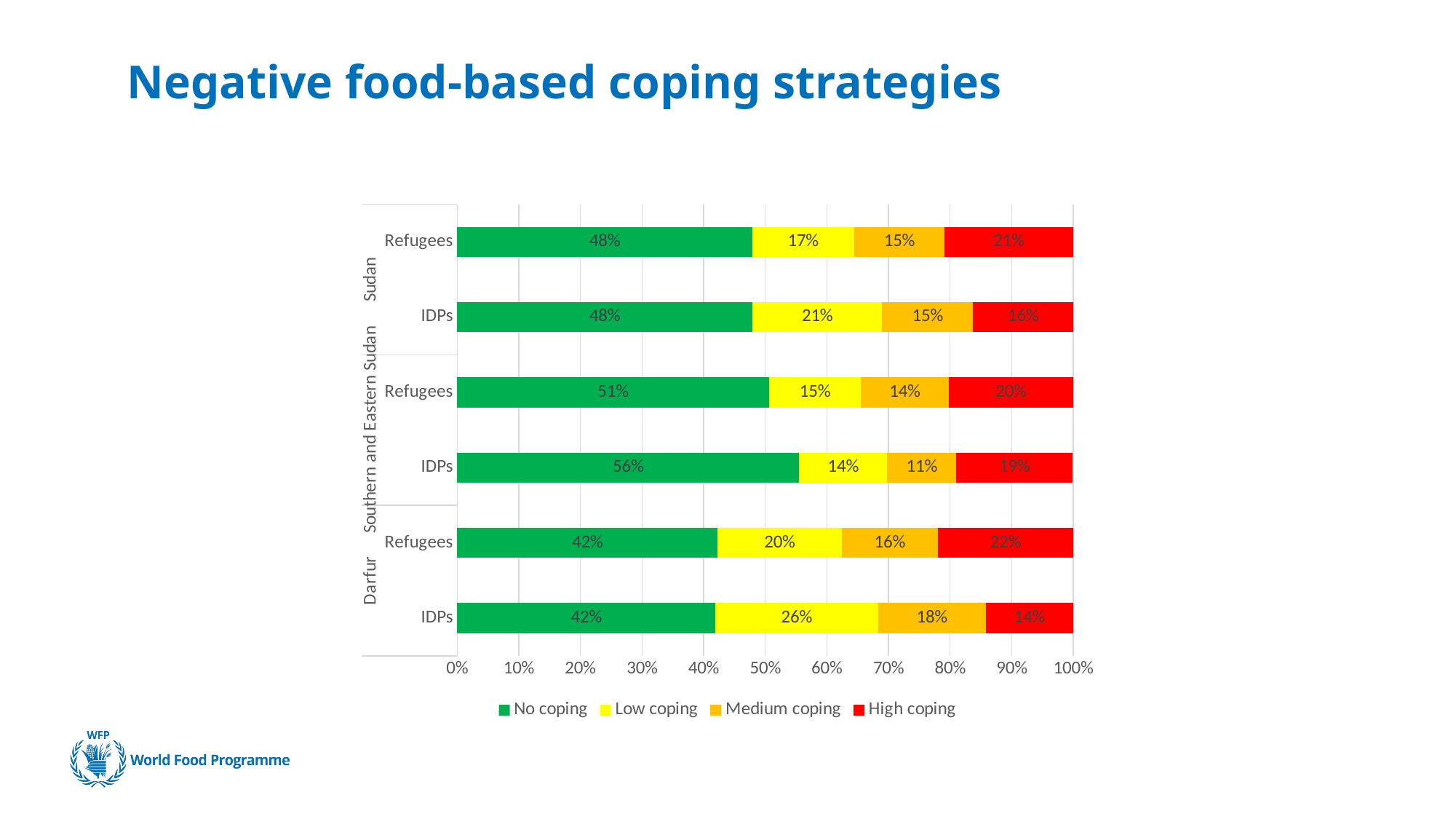
What is the "Low coping" value for IDPs in Sudan? 21% Which group has the lowest "High coping" share? Darfur IDPs Which is larger: the "Medium coping" value for Darfur IDPs or for Southern and Eastern Sudan IDPs? Darfur IDPs What is the "High coping" value for Refugees in Southern and Eastern Sudan? 20% How many groups (bars) are shown in the chart? 6 How many series does the legend list? 4 What is the difference between the "Low coping" values for Darfur IDPs and Darfur Refugees? 6% Which colour represents "High coping" in the chart? Red What percentage of Darfur IDPs fall under "No coping"? 42% Which group has the highest "No coping" share? Southern and Eastern Sudan IDPs What kind of chart is shown on the slide? Stacked bar chart What is the title of the slide? Negative food-based coping strategies